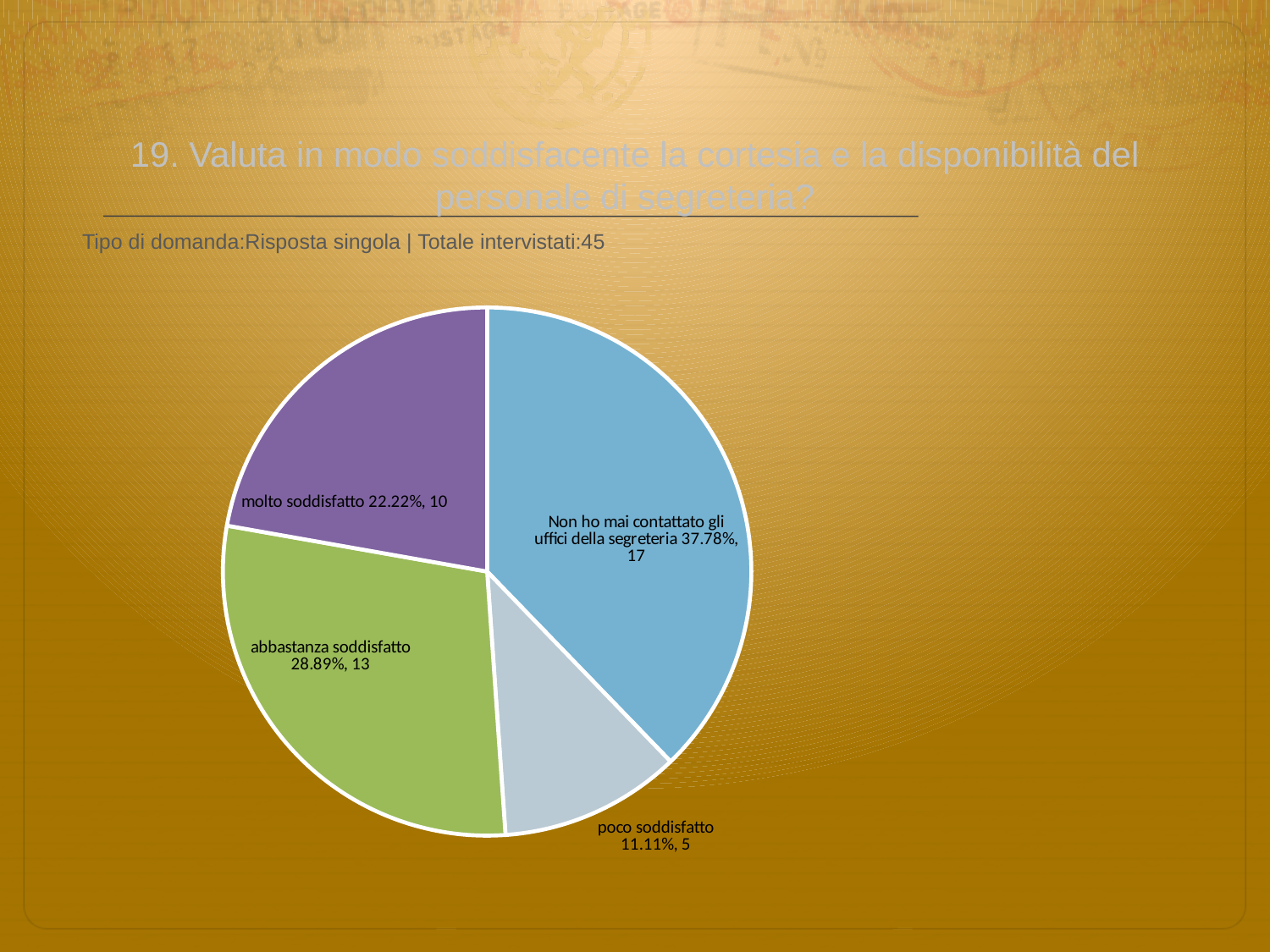
What is the total number of respondents across all slices? 45 What kind of chart is shown on the slide? pie chart What percentage share does the 'poco soddisfatto' slice have? 11.11% Which has more respondents, 'molto soddisfatto' or 'poco soddisfatto'? molto soddisfatto What is the difference in respondent count between 'abbastanza soddisfatto' and 'molto soddisfatto'? 3 What percentage share does the 'molto soddisfatto' slice have? 22.22% What colour is the 'abbastanza soddisfatto' slice? green Which category has the largest slice of the pie? Non ho mai contattato gli uffici della segreteria How many respondents chose 'abbastanza soddisfatto'? 13 How many slices does the pie chart have? 4 How many respondents chose 'Non ho mai contattato gli uffici della segreteria'? 17 Which category has the smallest slice of the pie? poco soddisfatto